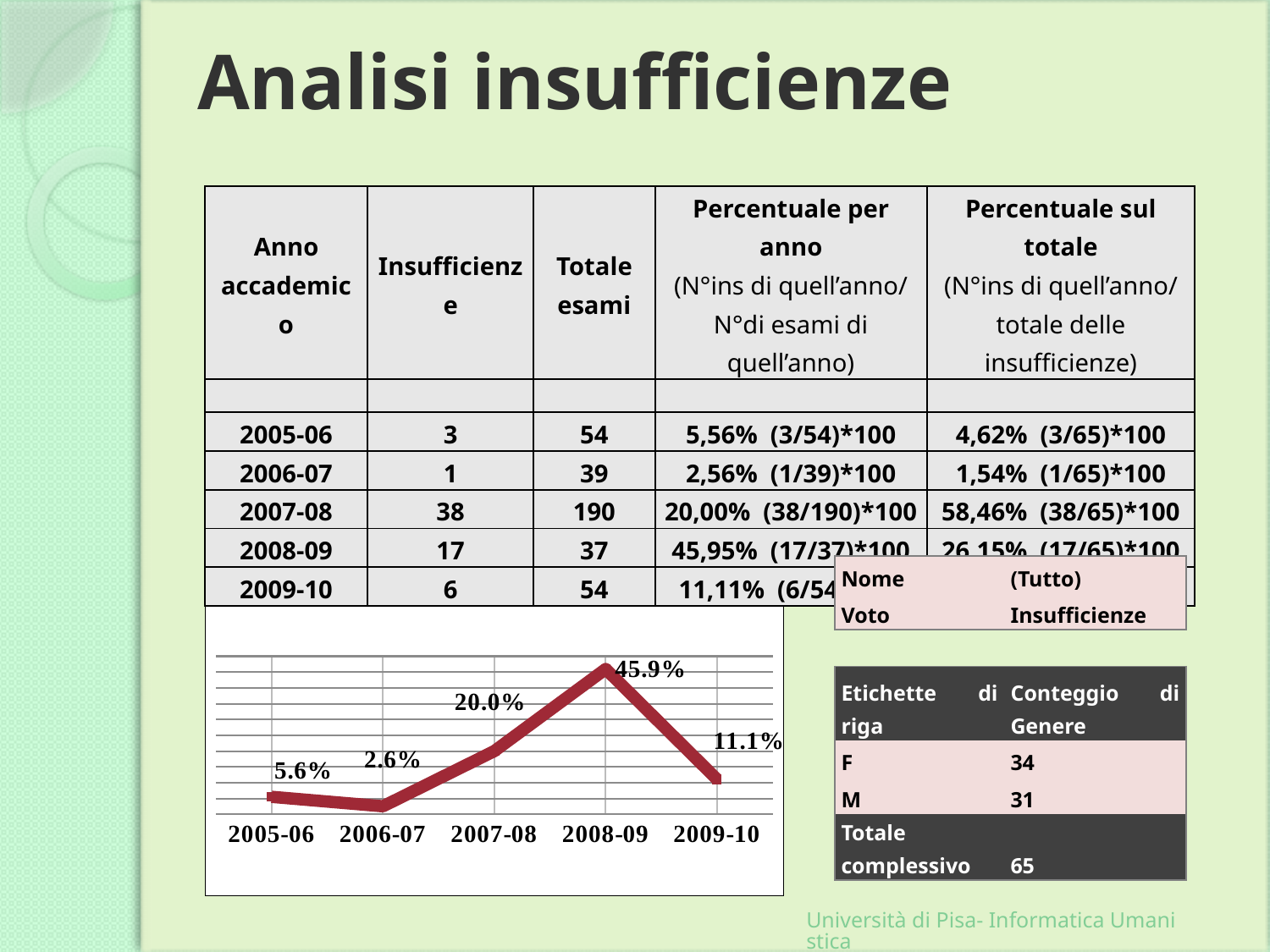
What is the value plotted for 2006-07 in the line chart? 2.6% What is the value plotted for 2009-10 in the line chart? 11.1% What is the value plotted for 2005-06 in the line chart? 5.6% Which academic year has the lowest value in the line chart? 2006-07 How many academic years are plotted on the x axis of the line chart? 5 Does the line rise or fall between 2008-09 and 2009-10? fall Which academic year has the highest value in the line chart? 2008-09 What is the value plotted for 2008-09 in the line chart? 45.9% What is the difference between the values for 2008-09 and 2007-08 in the line chart? 25.9% What colour is the line in the chart? dark red What kind of chart is shown on the slide? line chart In the line chart, is the value for 2007-08 larger or smaller than the value for 2009-10? larger